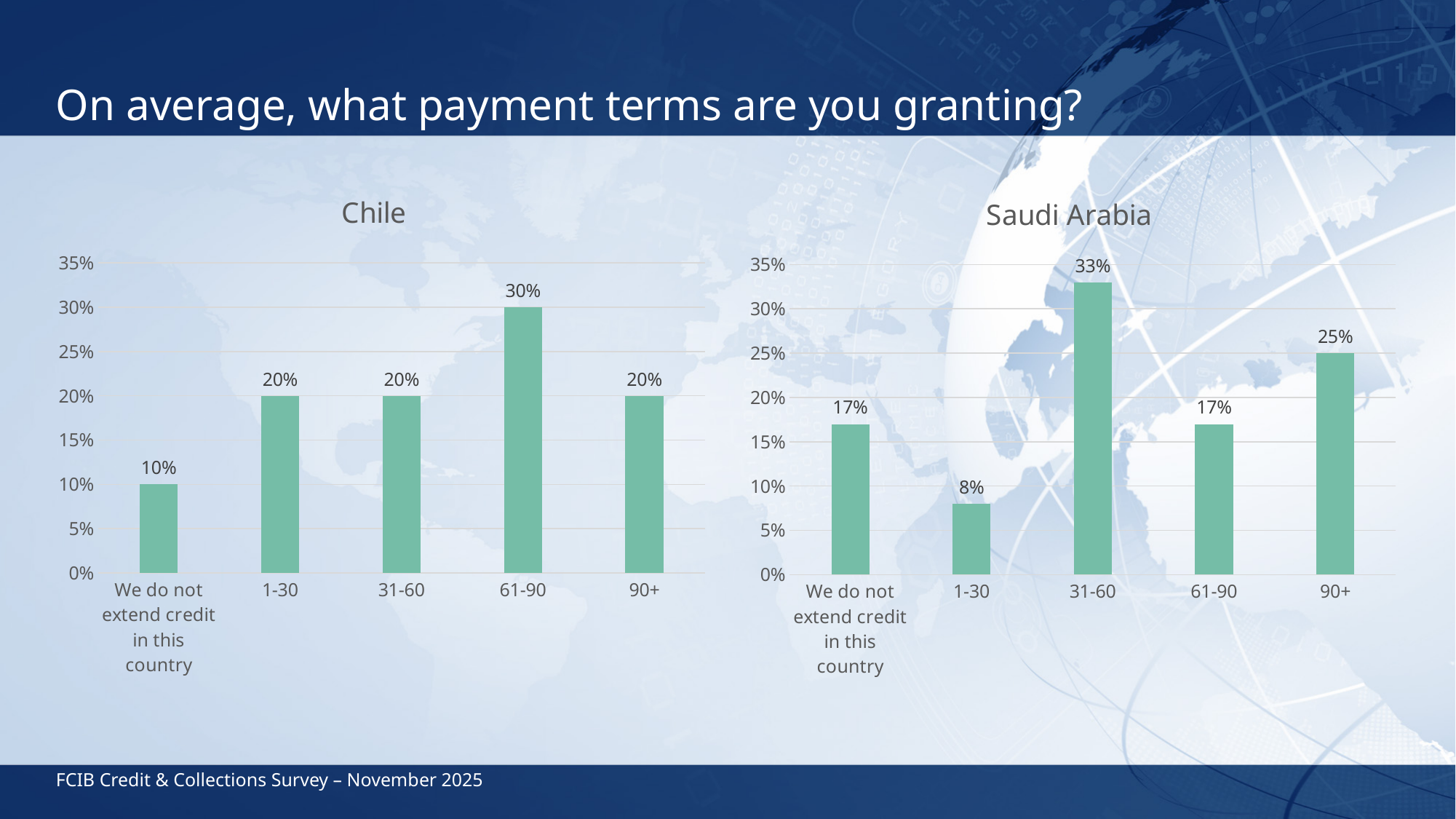
In the Saudi Arabia chart, what is the value for 1-30? 8% In the Chile chart, what is the difference between the values for 61-90 and 1-30? 10% How many categories are shown in the Chile chart? 5 In the Chile chart, what is the value for 'We do not extend credit in this country'? 10% In the Saudi Arabia chart, which category has the highest value? 31-60 What is the title of the chart on the left side of the slide? Chile In the Chile chart, what is the value for 61-90? 30% In the Chile chart, which category has the lowest value? We do not extend credit in this country What kind of chart is the Saudi Arabia chart? Bar chart Which is larger: the value for 90+ in the Chile chart or the value for 90+ in the Saudi Arabia chart? Saudi Arabia In the Saudi Arabia chart, which category has the lowest value? 1-30 In the Saudi Arabia chart, what is the difference between the values for 31-60 and 90+? 8%